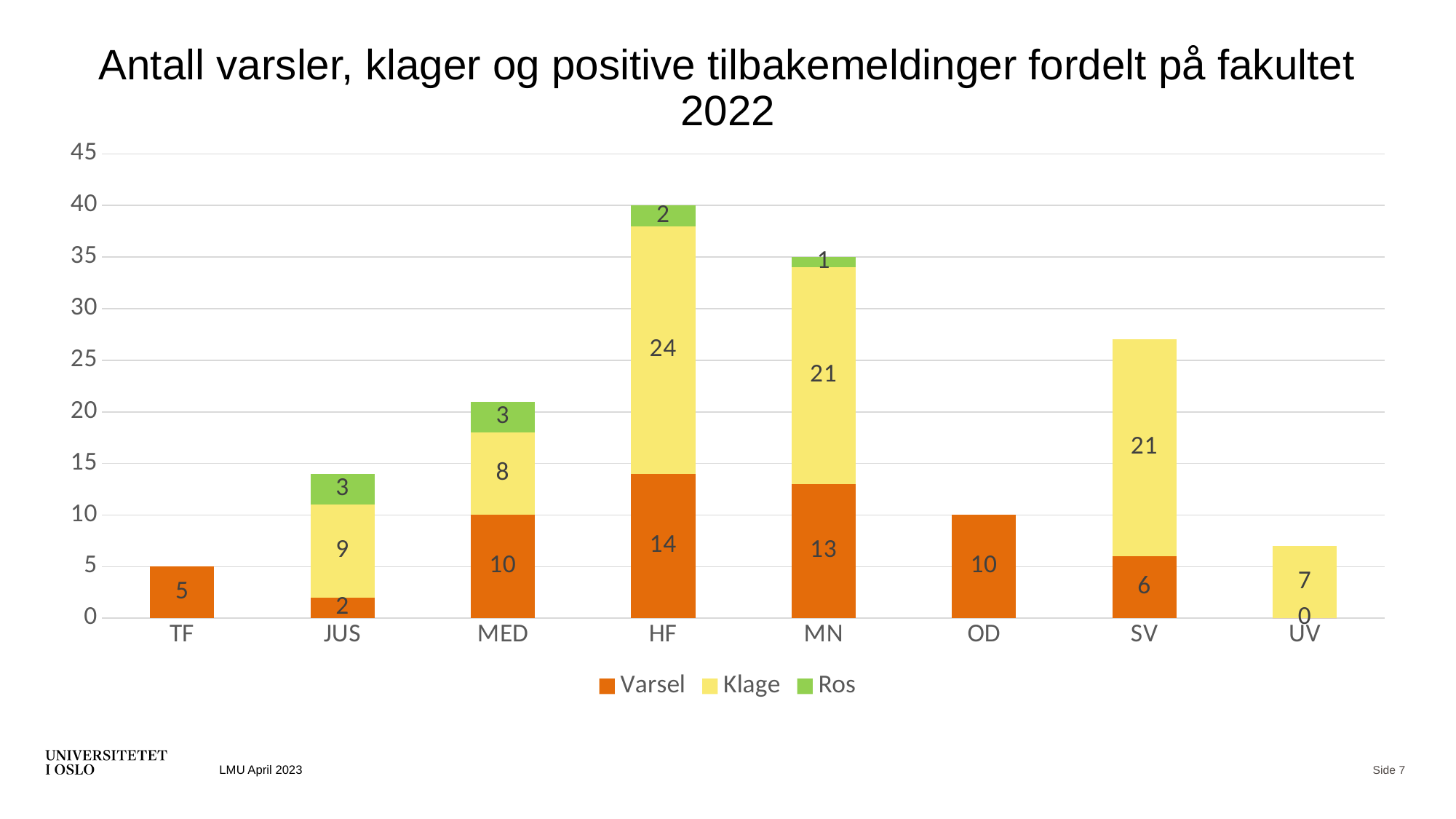
How many series does the legend list? 3 What is the difference between the Klage values for HF and MN? 3 Which faculty has the lowest total stacked bar? TF How many faculties are shown on the x axis? 8 Which faculty has the highest Klage value? HF What is the total of the stacked bar for HF? 40 What is the Ros value for MED? 3 What is the Varsel value for HF? 14 Which is larger, the Varsel value for MED or the Varsel value for SV? MED What is the Klage value for SV? 21 What is the Varsel value for UV? 0 What is the total of the stacked bar for JUS? 14